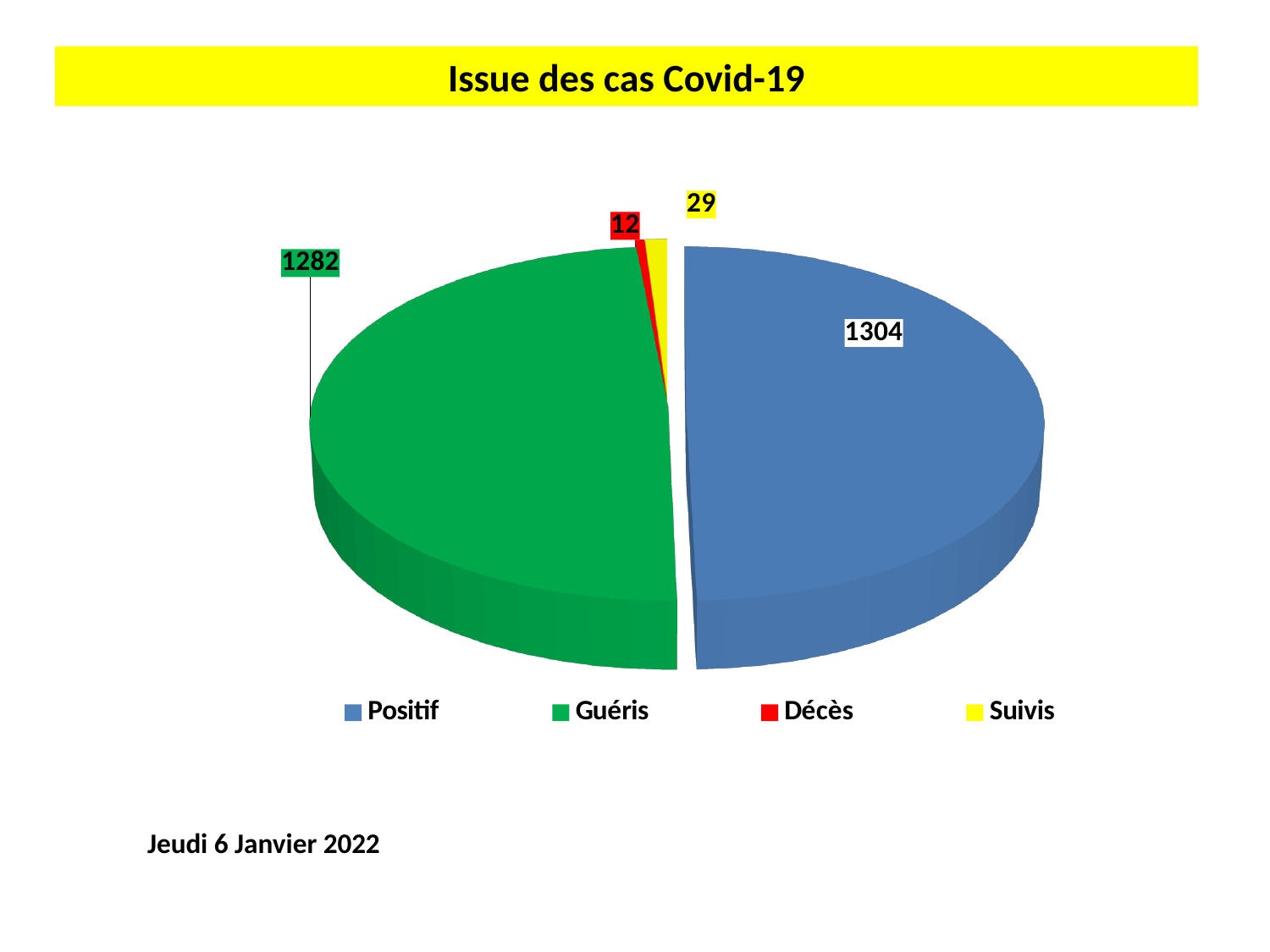
What is the value for Suivis? 29 Which category has the highest value? Positif What is the value for Guéris? 1282 What is the value for Décès? 12 What kind of chart is shown on the slide? Pie chart What is the difference between the values for Suivis and Décès? 17 What is the difference between the values for Positif and Guéris? 22 How many categories does the pie chart show? 4 What is the value for Positif? 1304 Which category has the lowest value? Décès Which is larger, the value for Suivis or the value for Décès? Suivis What is the title of the chart? Issue des cas Covid-19